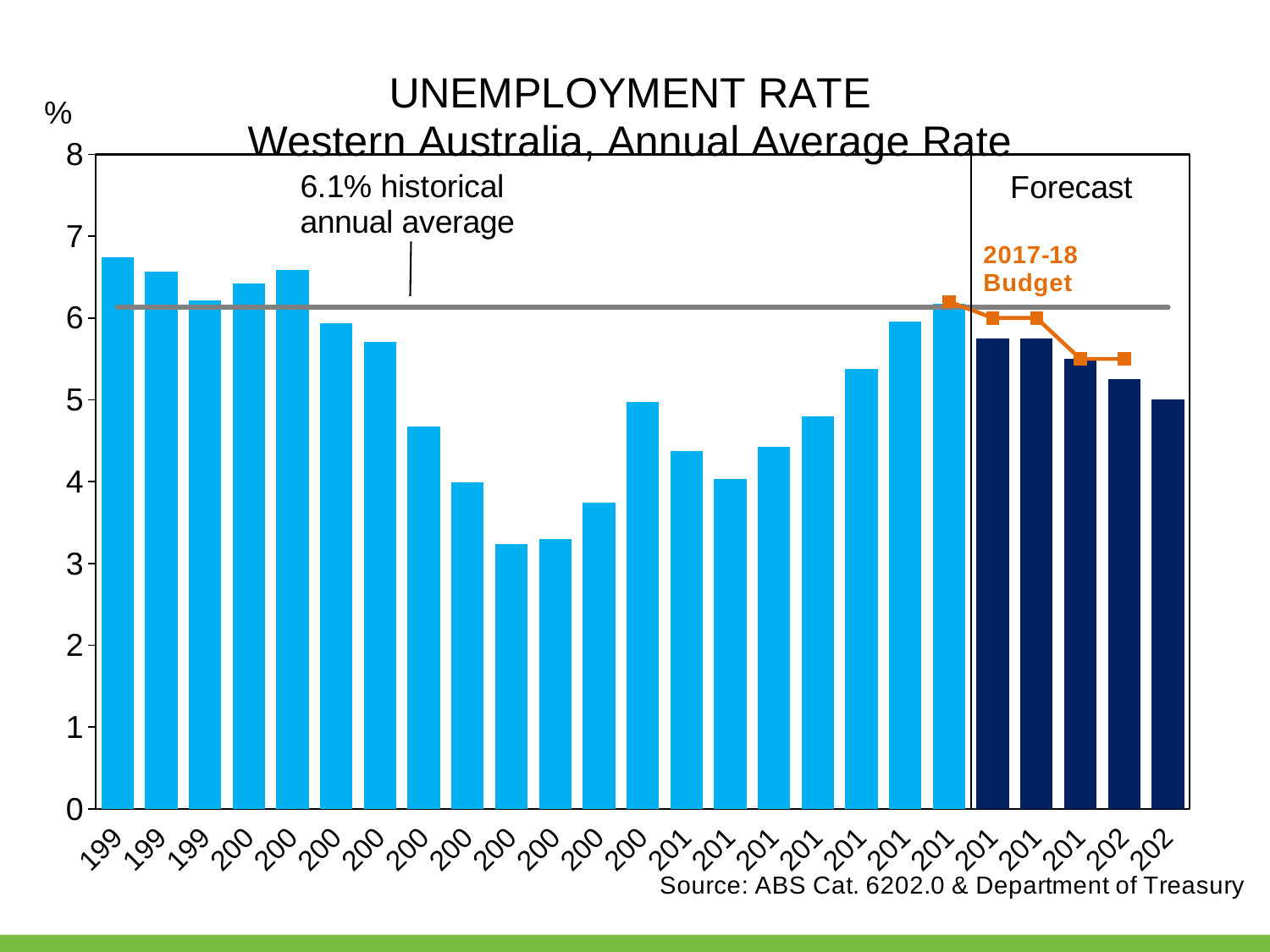
Is the first bar on the left above or below the 6.1% historical annual average line? above Do the bars in the Forecast section rise or fall from left to right? fall Is the value of the lowest bar on the chart greater or less than 4? less What is the highest value shown on the vertical axis? 8 What value does the horizontal grey line labelled as the historical annual average represent? 6.1% Is the value of the first (leftmost) bar greater or less than 6? greater How many bars are plotted in total on the chart? 25 What kind of chart is shown on the slide? combination bar and line chart What label is given to the orange line with square markers in the Forecast section? 2017-18 Budget How many dark navy bars are in the Forecast section of the chart? 5 Which is larger, the first bar on the left or the last bar on the right? the first bar on the left Is the value of the last (rightmost) forecast bar greater or less than 6? less